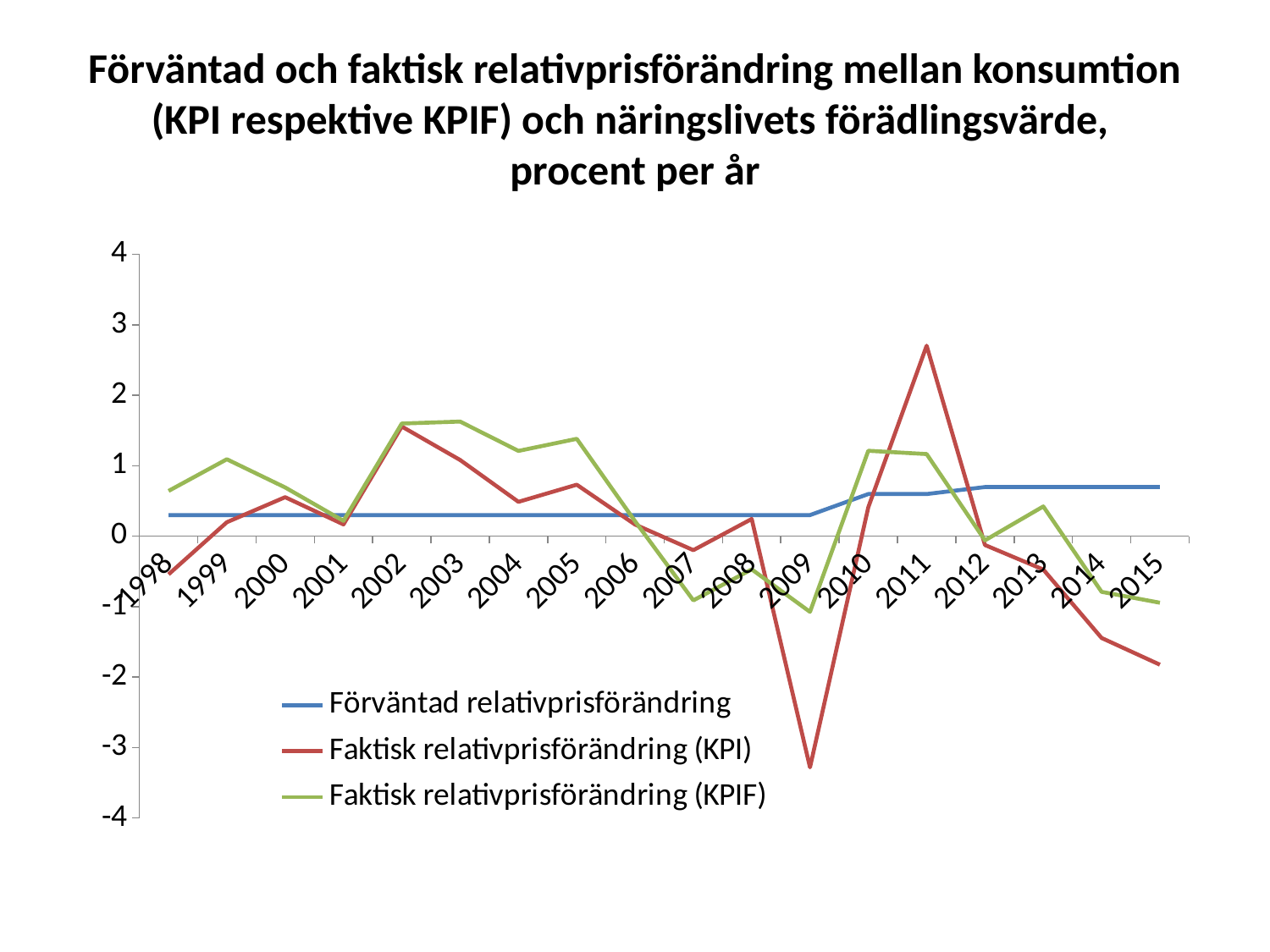
What kind of chart is shown on the slide? Line chart Is the value for Faktisk relativprisförändring (KPI) in 2011 greater or less than 2? greater In 2011, which is larger: Faktisk relativprisförändring (KPI) or Faktisk relativprisförändring (KPIF)? Faktisk relativprisförändring (KPI) Does the Faktisk relativprisförändring (KPI) line rise or fall between 2011 and 2015? Fall In which year is the Faktisk relativprisförändring (KPI) line at its highest? 2011 How many years are plotted along the x axis? 18 In which year is the Faktisk relativprisförändring (KPI) line at its lowest? 2009 In 2009, which is larger: Faktisk relativprisförändring (KPI) or Faktisk relativprisförändring (KPIF)? Faktisk relativprisförändring (KPIF) What colour is the Faktisk relativprisförändring (KPIF) line? Green How many series does the legend list? 3 Does the Förväntad relativprisförändring line rise or fall between 2009 and 2012? Rise Is the value for Faktisk relativprisförändring (KPI) in 2009 greater or less than -3? less